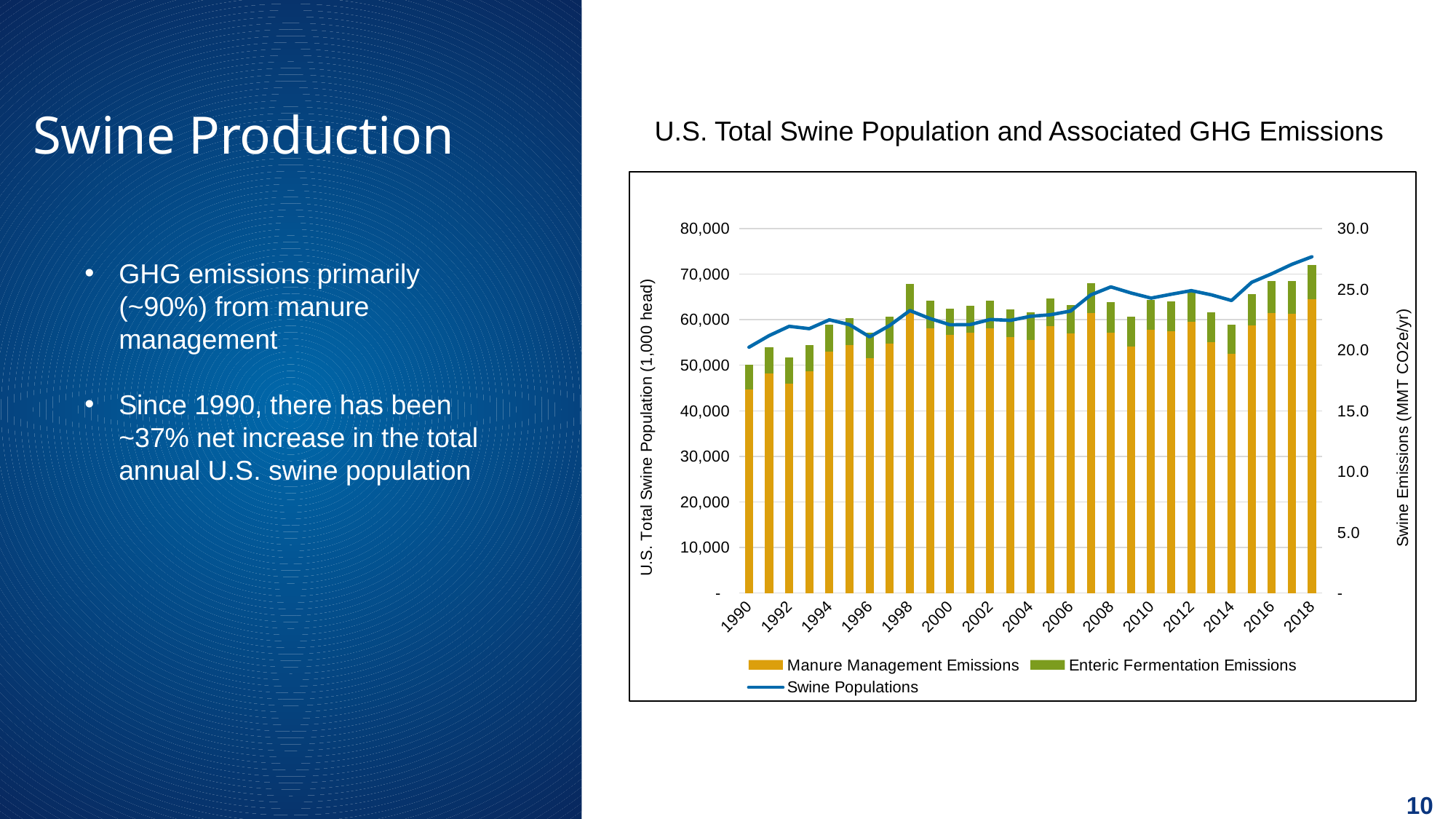
Which year has the tallest stacked bar? 2018 How many series does the chart legend list? 3 Does the Swine Populations line generally rise or fall from 1990 to 2018? Rise In which year is the Swine Populations line at its lowest? 1990 In which year is the Swine Populations line at its highest? 2018 How many years (bars) are plotted along the x axis of the chart? 29 Which year has the shortest stacked bar? 1990 What kind of chart is shown on the slide? A combination chart of stacked bars and a line What is the title of the chart? U.S. Total Swine Population and Associated GHG Emissions Which series is drawn as a line in the chart? Swine Populations